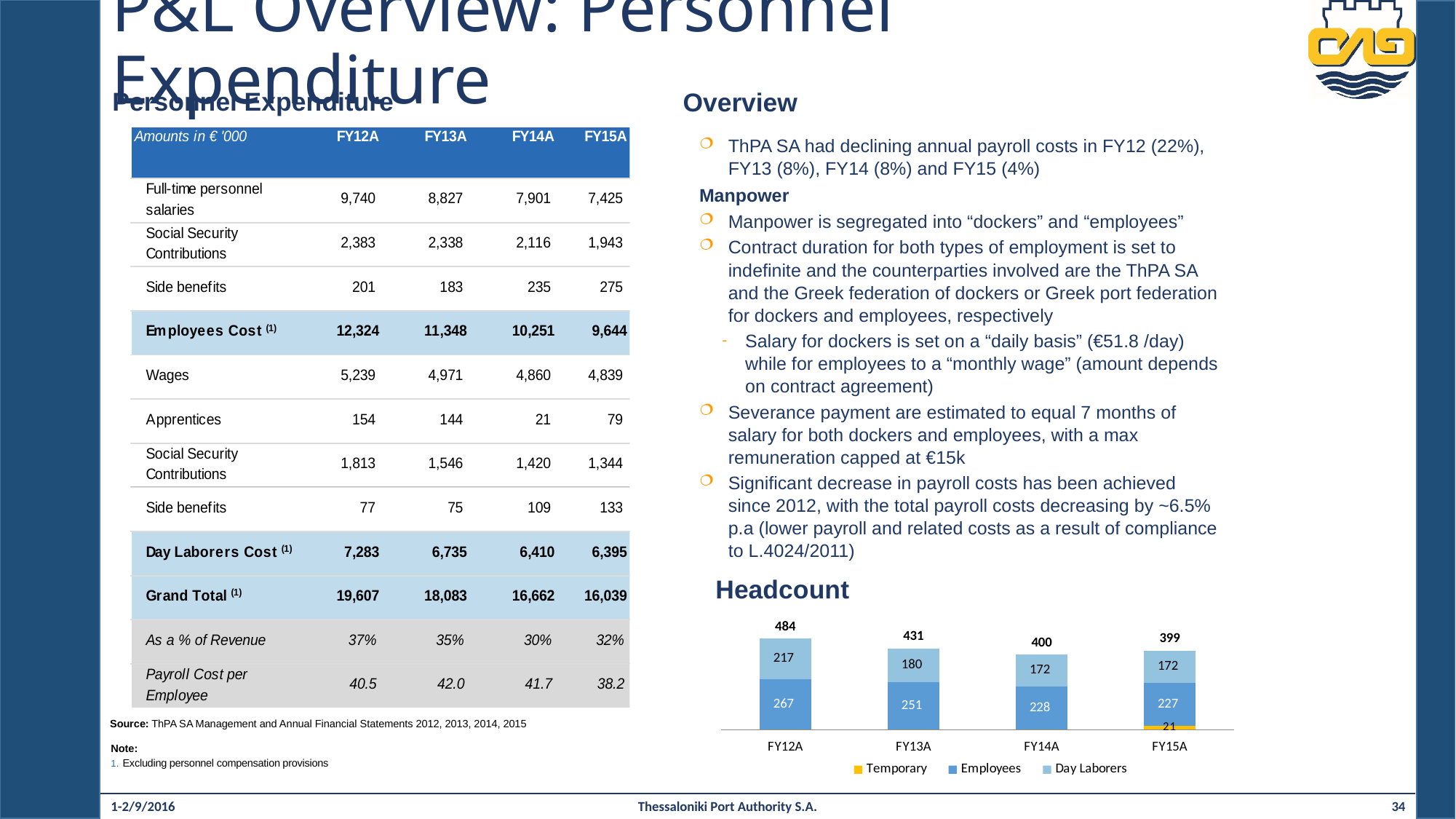
In the Headcount chart, what is the total headcount for FY14A? 400 What kind of chart is the Headcount chart? stacked bar chart In the Headcount chart, which fiscal year has the lowest total headcount? FY15A In the Headcount chart, how many fiscal years are shown on the x axis? 4 In the Headcount chart, what is the Employees value for FY12A? 267 In the Headcount chart, what is the Day Laborers value for FY13A? 180 In the Headcount chart, what is the difference between the Employees values for FY12A and FY15A? 40 In the Headcount chart, how many series does the legend list? 3 In the Headcount chart, what is the Temporary value for FY15A? 21 In the Headcount chart, do the total headcount values rise or fall from FY12A to FY15A? fall In the Headcount chart, which fiscal year has the highest total headcount? FY12A In the Headcount chart, is the Day Laborers value larger in FY12A or FY14A? FY12A